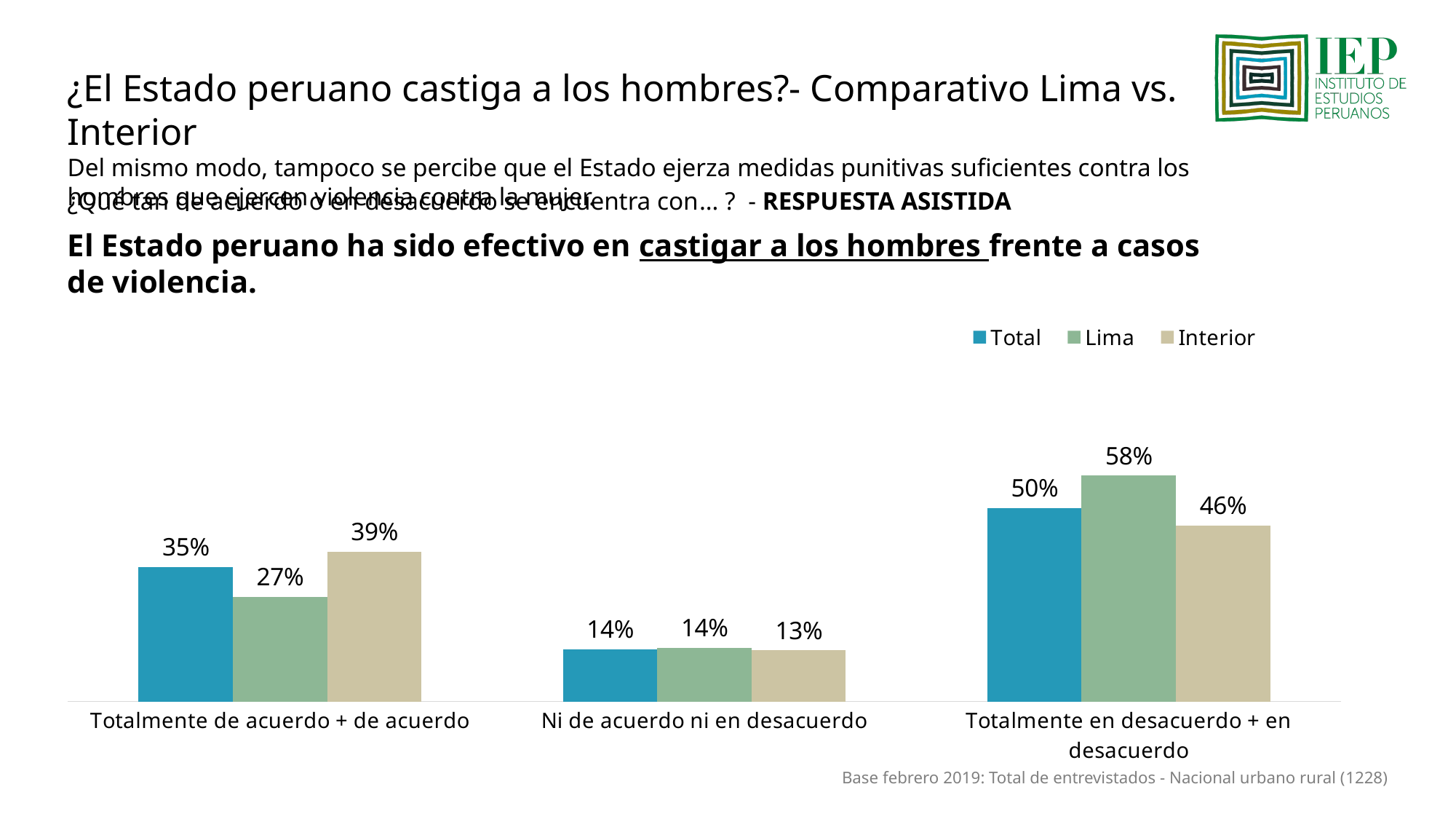
What is the difference between the Lima and Interior values for "Totalmente en desacuerdo + en desacuerdo"? 12% For "Totalmente de acuerdo + de acuerdo", which is larger: the Total value or the Lima value? Total How many series does the legend list? 3 What is the Interior value for "Totalmente de acuerdo + de acuerdo"? 39% What is the Lima value for "Totalmente en desacuerdo + en desacuerdo"? 58% What is the Total value for "Ni de acuerdo ni en desacuerdo"? 14% Which series is shown in blue in the legend? Total Which category has the lowest Interior value? Ni de acuerdo ni en desacuerdo What is the difference between the Interior and Lima values for "Totalmente de acuerdo + de acuerdo"? 12% Which category has the highest Total value? Totalmente en desacuerdo + en desacuerdo What kind of chart is shown on the slide? Bar chart How many categories are shown on the x axis? 3